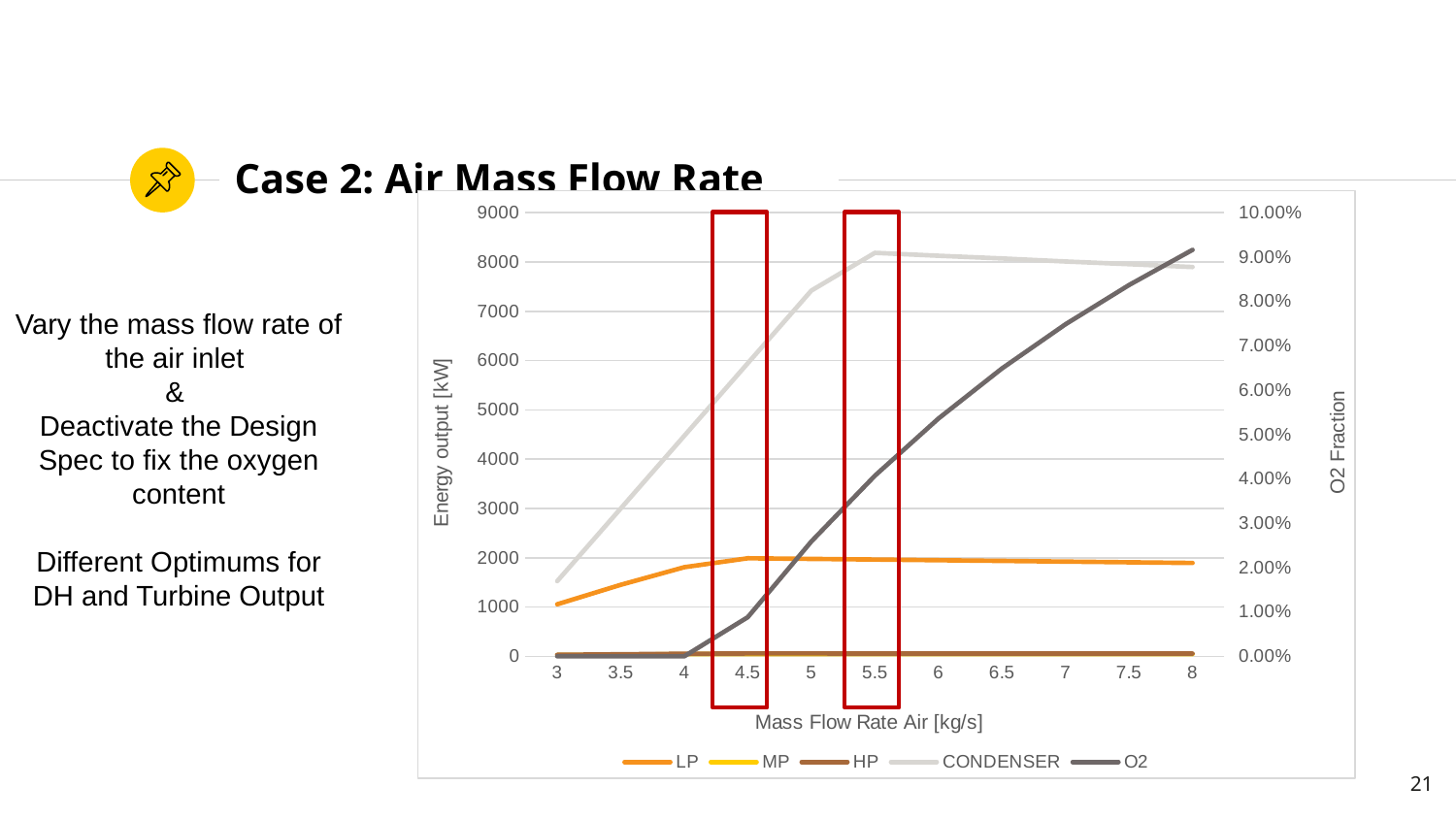
What is the title of the x axis? Mass Flow Rate Air [kg/s] Is the LP energy output at 5 kg/s greater or less than 1000? greater Which series has the highest energy output at 6 kg/s? CONDENSER Is the O2 fraction at 8 kg/s greater or less than 8.00%? greater Is the O2 fraction at 4 kg/s greater or less than 1.00%? less What are the series names listed in the legend? LP, MP, HP, CONDENSER, O2 Does the O2 fraction rise or fall as the mass flow rate of air increases from 4 to 8 kg/s? rises What kind of chart is shown on the slide? line chart How many series does the legend list? 5 At 8 kg/s, which has the larger energy output, CONDENSER or LP? CONDENSER